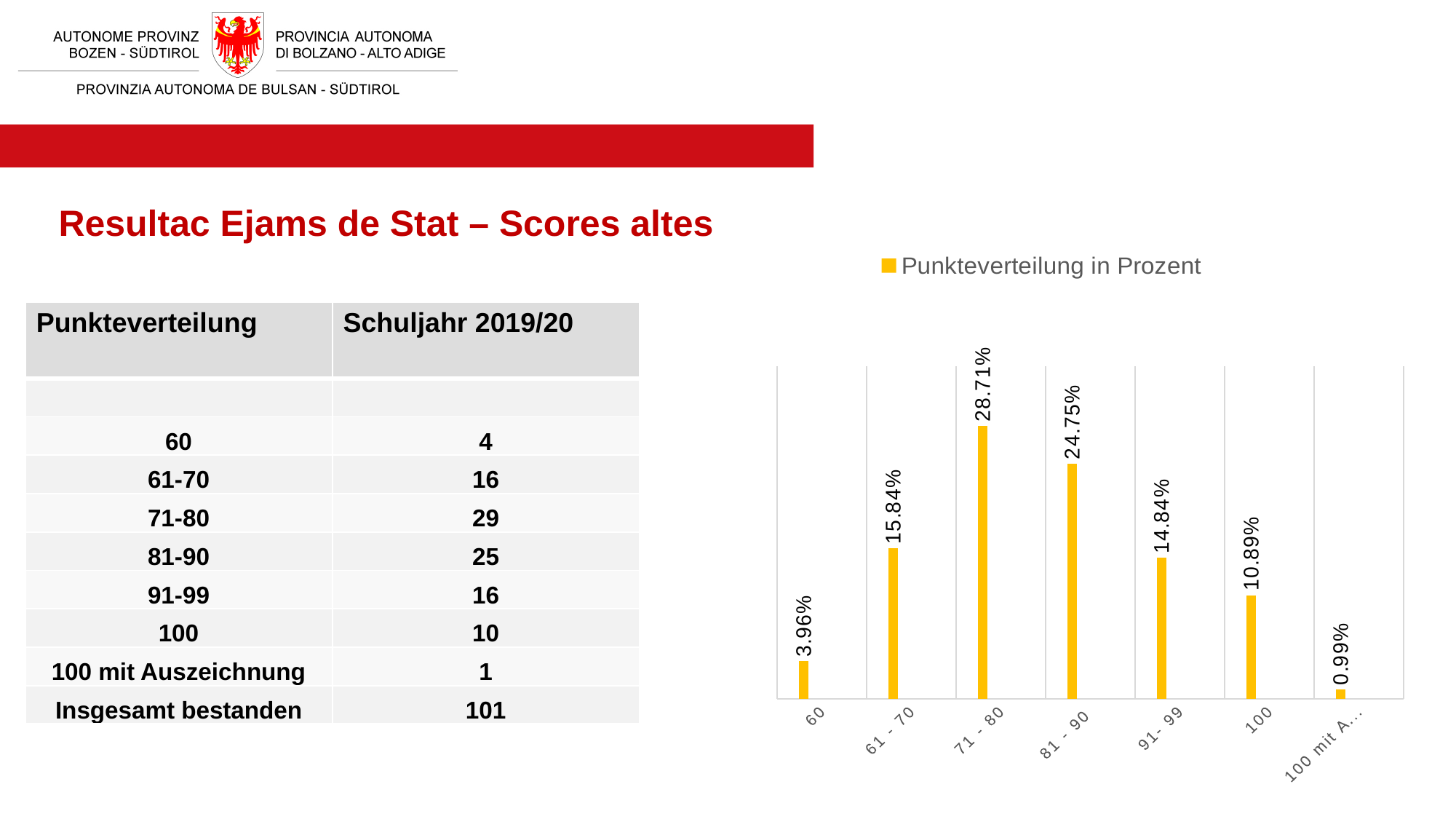
Which category has the lowest value in the chart? 100 mit Auszeichnung Which is larger in the chart, the value for 61 - 70 or the value for 100? 61 - 70 What is the value for the 100 category in the chart? 10.89% Which category has the highest value in the chart? 71 - 80 What is the value for the 91 - 99 category in the chart? 14.84% What is the value for the 71 - 80 category in the chart? 28.71% What series name does the chart legend show? Punkteverteilung in Prozent How many categories are plotted in the chart? 7 What is the value for the 60 category in the chart? 3.96% What is the difference between the values for 61 - 70 and 91 - 99 in the chart? 1.00% What kind of chart is shown on the slide? bar chart What is the difference between the values for 71 - 80 and 81 - 90 in the chart? 3.96%